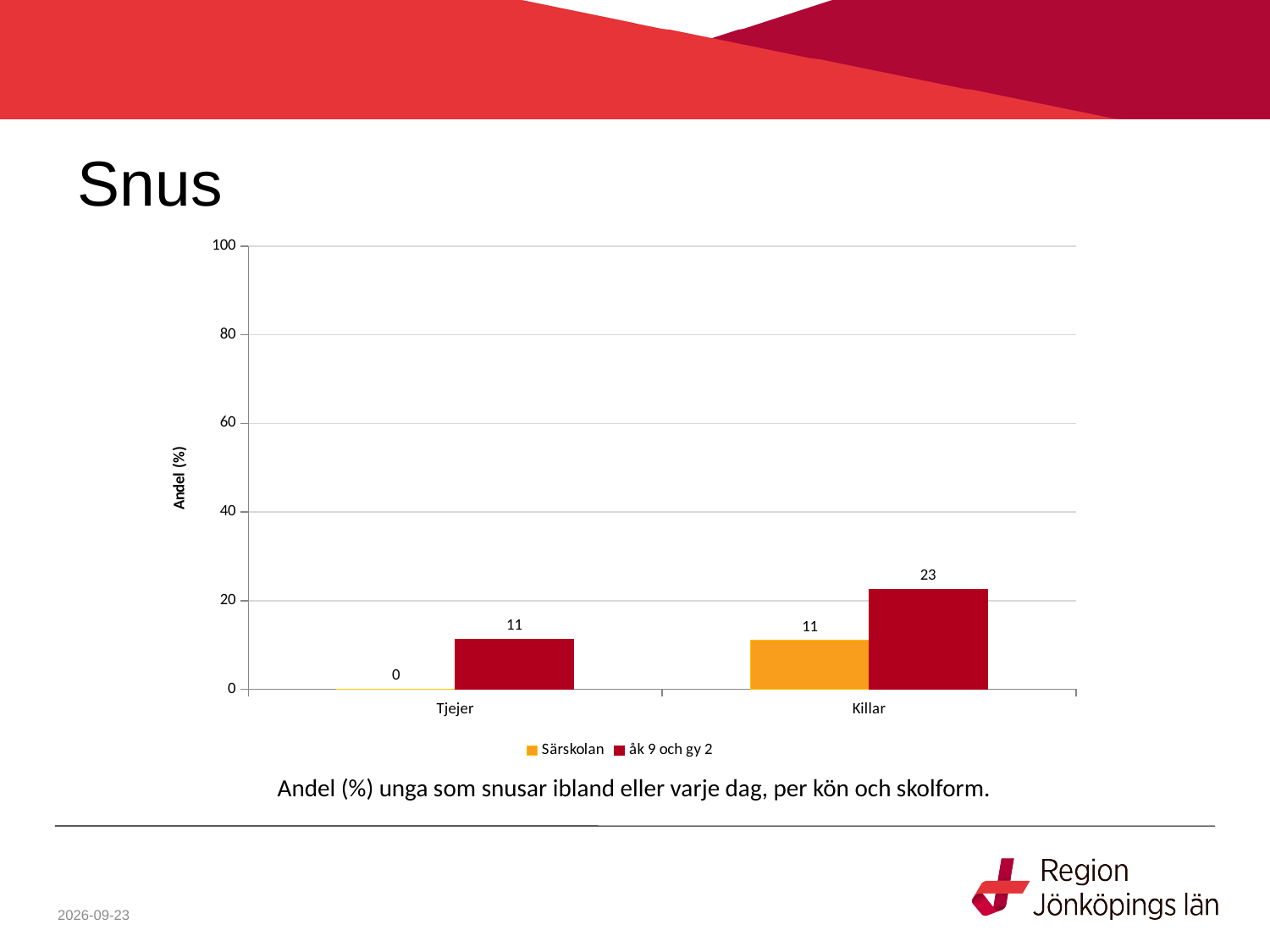
What is the value for Särskolan in the Tjejer category? 0 Which bar has the highest value on the chart? åk 9 och gy 2, Killar What is the difference between the åk 9 och gy 2 values for Killar and Tjejer? 12 What is the value for Särskolan in the Killar category? 11 What is the value for åk 9 och gy 2 in the Killar category? 23 How many categories are shown on the x axis? 2 How many series does the legend list? 2 What is the value for åk 9 och gy 2 in the Tjejer category? 11 Is the value for åk 9 och gy 2 in the Killar category greater or less than 40? less Which is larger for Killar: Särskolan or åk 9 och gy 2? åk 9 och gy 2 Which bar has the lowest value on the chart? Särskolan, Tjejer What kind of chart is shown on the slide? bar chart